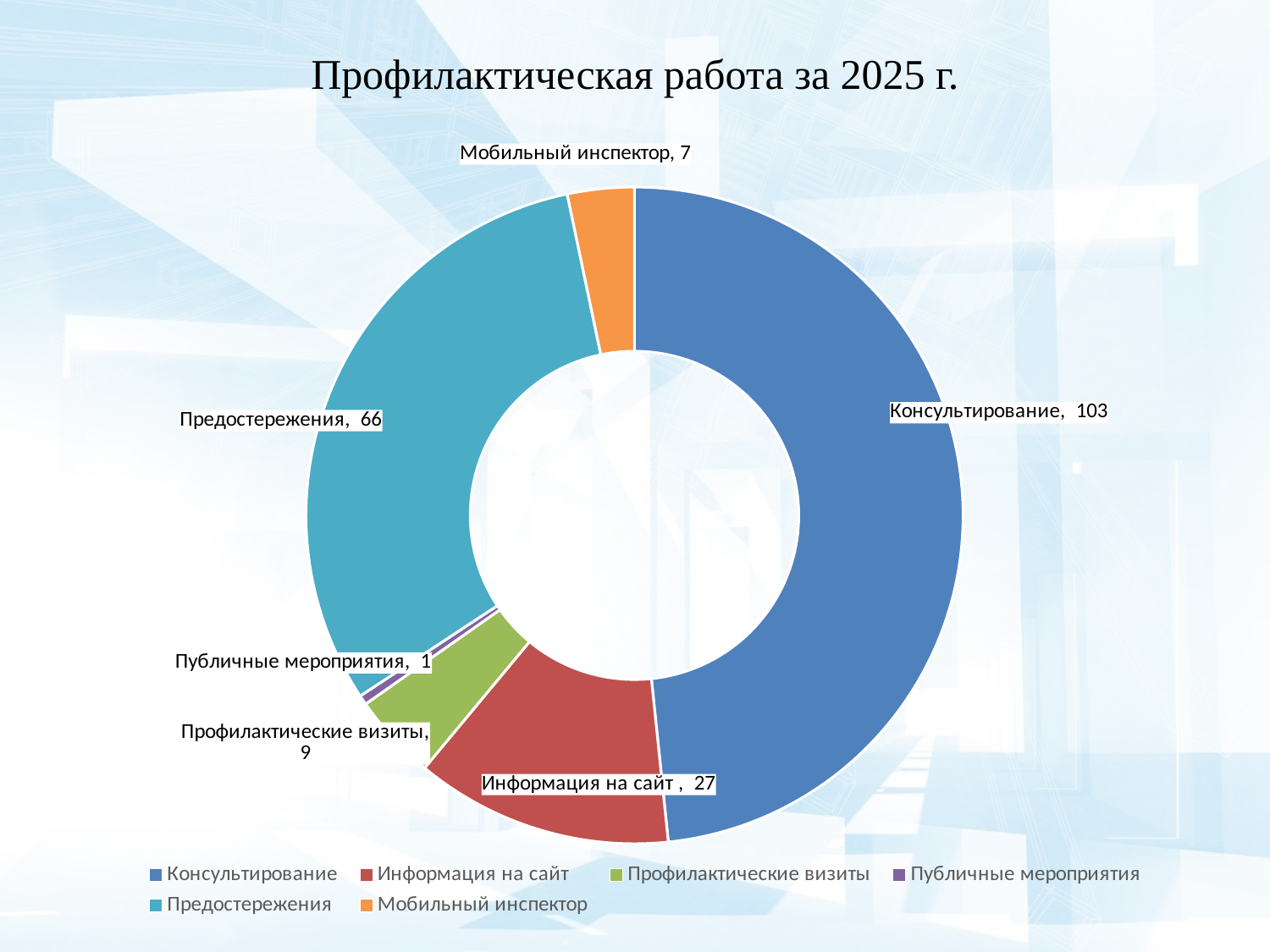
What is the title of the chart? Профилактическая работа за 2025 г. Which category has the highest value? Консультирование How many categories are shown in the chart? 6 Which is larger, Информация на сайт or Профилактические визиты? Информация на сайт What is the value for Информация на сайт? 27 What is the difference between Консультирование and Предостережения? 37 What is the value for Консультирование? 103 What is the value for Мобильный инспектор? 7 Which category has the lowest value? Публичные мероприятия What kind of chart is shown on the slide? Pie (doughnut) chart What is the total of all categories in the chart? 213 What is the value for Предостережения? 66